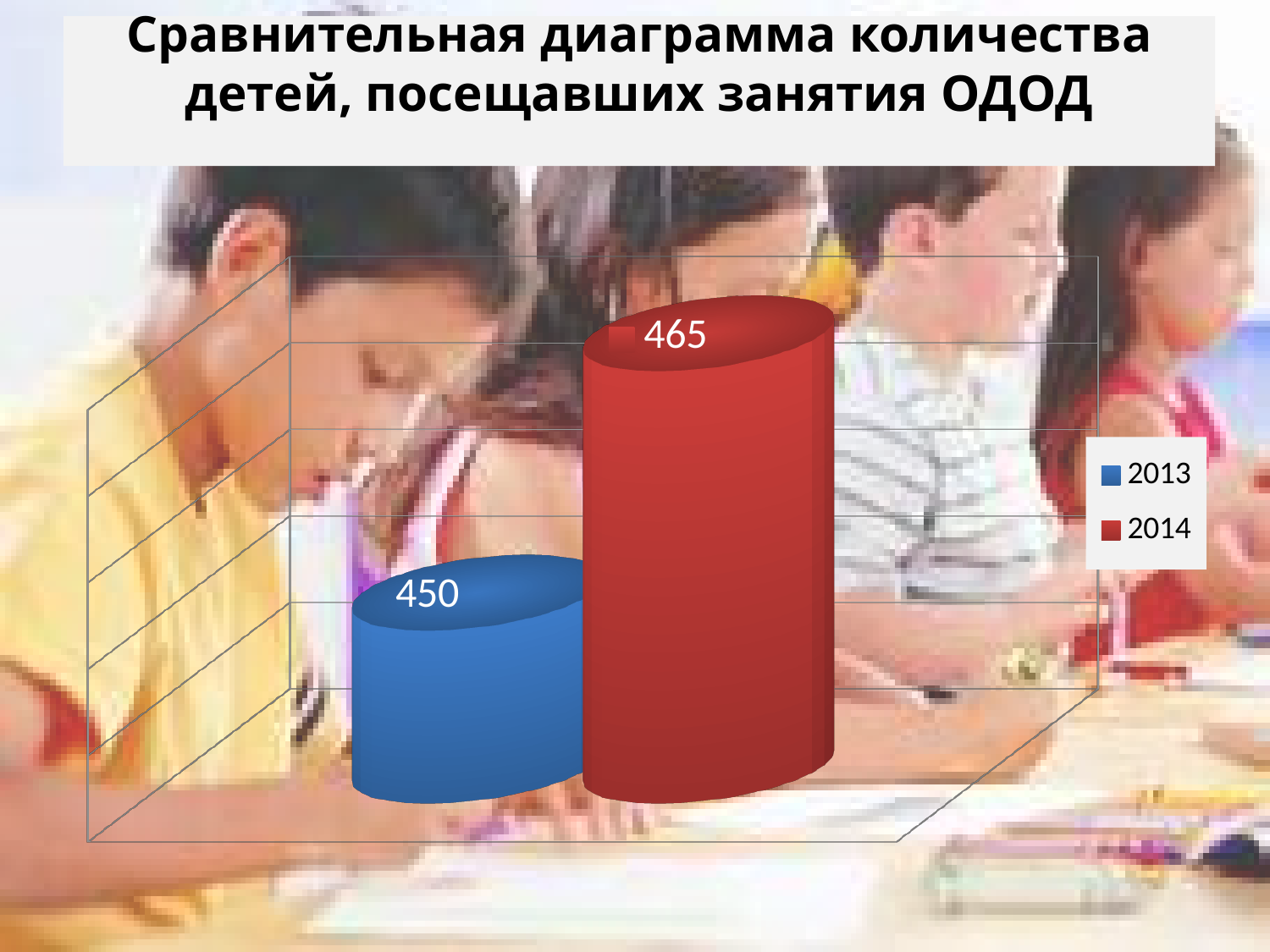
What is the title of the chart? Сравнительная диаграмма количества детей, посещавших занятия ОДОД What is the value for 2014? 465 Does the value rise or fall from 2013 to 2014? Rise Which year has the lowest value? 2013 What is the value for 2013? 450 What is the difference between the values for 2014 and 2013? 15 How many bars are plotted on the chart? 2 What kind of chart is shown on the slide? Bar chart Which year has the higher value, 2013 or 2014? 2014 What colour is the bar for 2014? Red How many series does the legend list? 2 Which year has the highest value? 2014